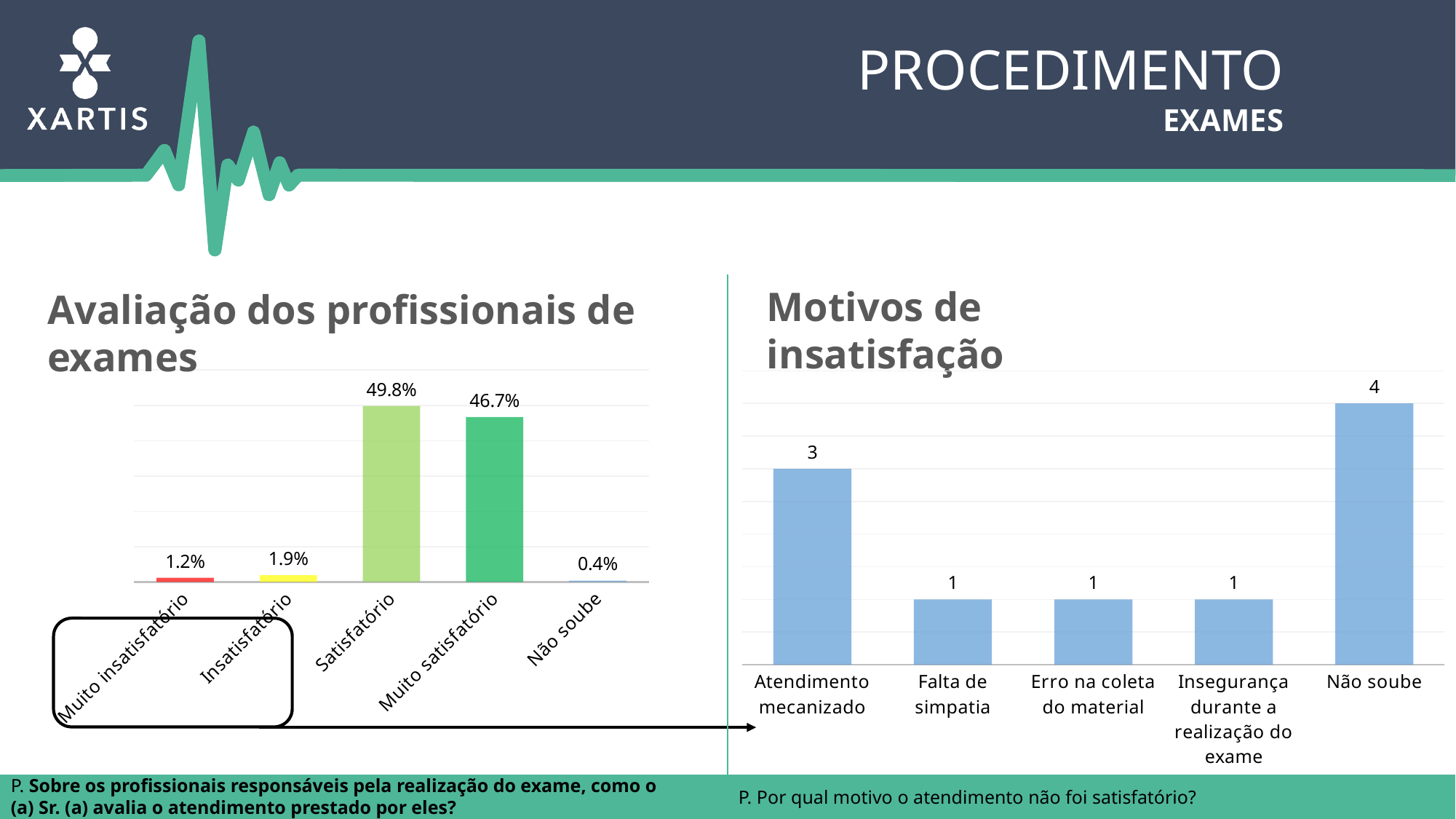
What type of chart is the 'Motivos de insatisfação' chart? Bar chart How many categories does the 'Avaliação dos profissionais de exames' chart show? 5 In the 'Avaliação dos profissionais de exames' chart, what is the value for Satisfatório? 49.8% In the 'Avaliação dos profissionais de exames' chart, what is the difference between Satisfatório and Muito satisfatório? 3.1% In the 'Avaliação dos profissionais de exames' chart, which is larger: Insatisfatório or Muito insatisfatório? Insatisfatório In the 'Motivos de insatisfação' chart, which category has the highest value? Não soube How many categories does the 'Motivos de insatisfação' chart show? 5 In the 'Motivos de insatisfação' chart, what is the value for Atendimento mecanizado? 3 In the 'Avaliação dos profissionais de exames' chart, which category has the lowest value? Não soube In the 'Avaliação dos profissionais de exames' chart, which category has the highest value? Satisfatório In the 'Avaliação dos profissionais de exames' chart, what is the value for Muito satisfatório? 46.7% In the 'Motivos de insatisfação' chart, what is the difference between Não soube and Falta de simpatia? 3